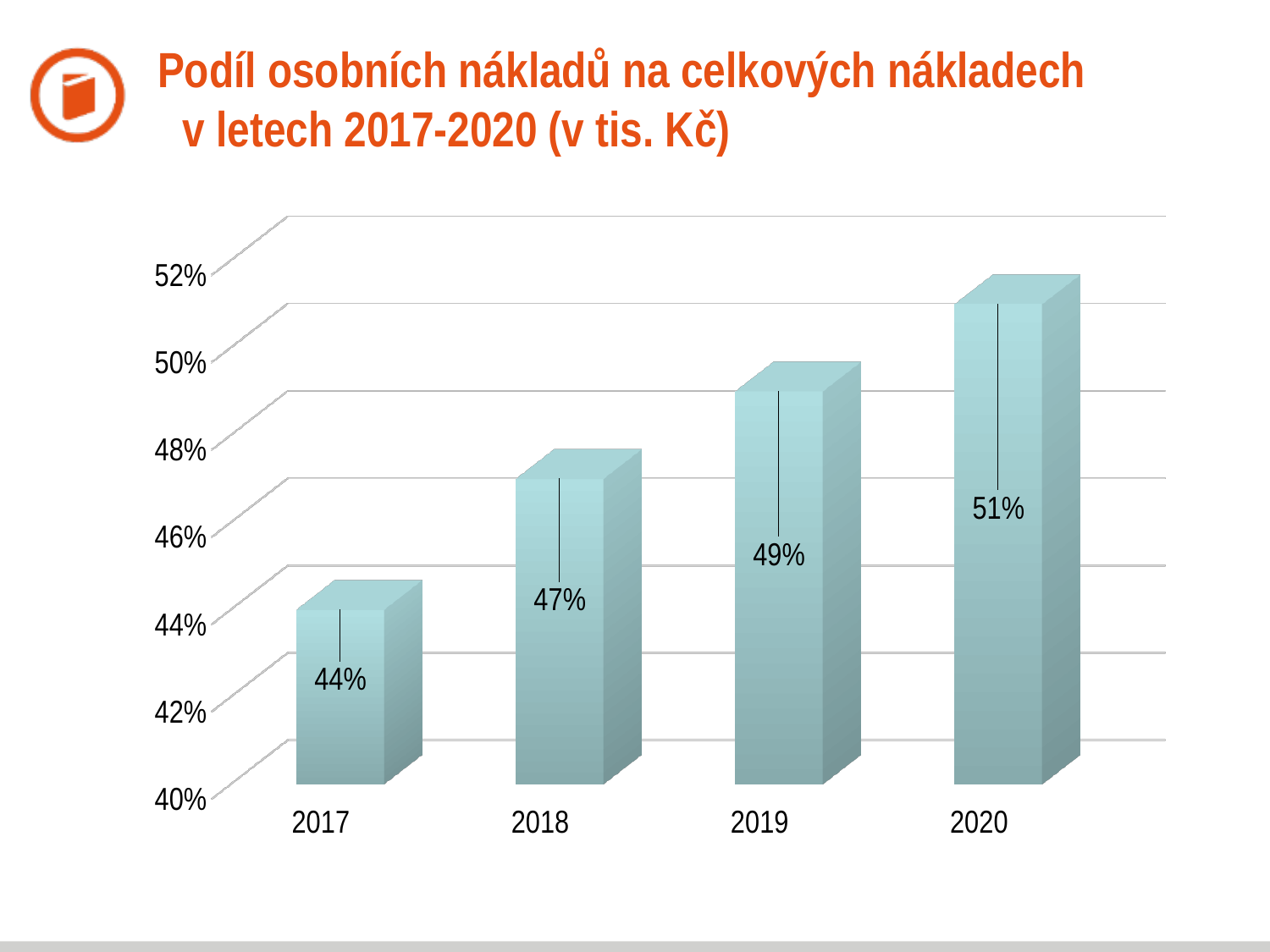
What kind of chart is shown on the slide? bar chart Do the values rise or fall from 2017 to 2020? rise Which year has the lowest value? 2017 What is the value for 2020? 51% What is the value for 2018? 47% What is the value for 2017? 44% How many years are shown on the x axis? 4 What is the value for 2019? 49% What is the difference between the values for 2020 and 2017? 7% Which is larger, the value for 2018 or the value for 2019? 2019 Is the value for 2019 greater or less than 48%? greater Which year has the highest value? 2020